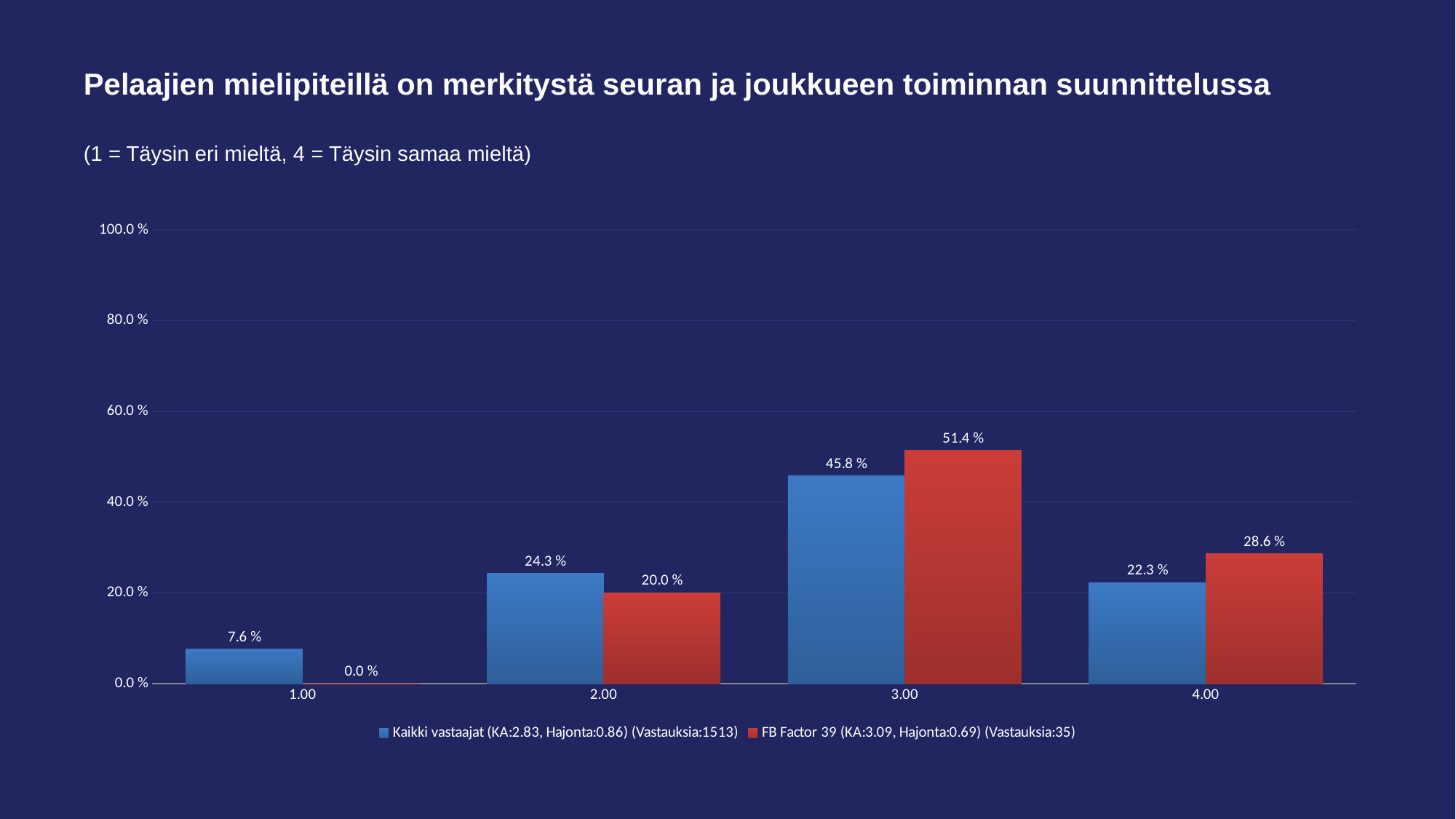
Which category has the lowest value for Kaikki vastaajat? 1.00 At category 2.00, which series has the larger value, Kaikki vastaajat or FB Factor 39? Kaikki vastaajat What is the value for FB Factor 39 at category 1.00? 0.0 % What is the value for Kaikki vastaajat at category 3.00? 45.8 % How many series does the legend list? 2 What is the difference between the FB Factor 39 and Kaikki vastaajat values at category 3.00? 5.6 % Is the value for Kaikki vastaajat at category 4.00 greater or less than 20.0 %? greater What is the value for FB Factor 39 at category 4.00? 28.6 % What is the value for Kaikki vastaajat at category 2.00? 24.3 % Which category has the highest value for FB Factor 39? 3.00 How many categories are shown on the x axis? 4 What kind of chart is shown on the slide? Bar chart